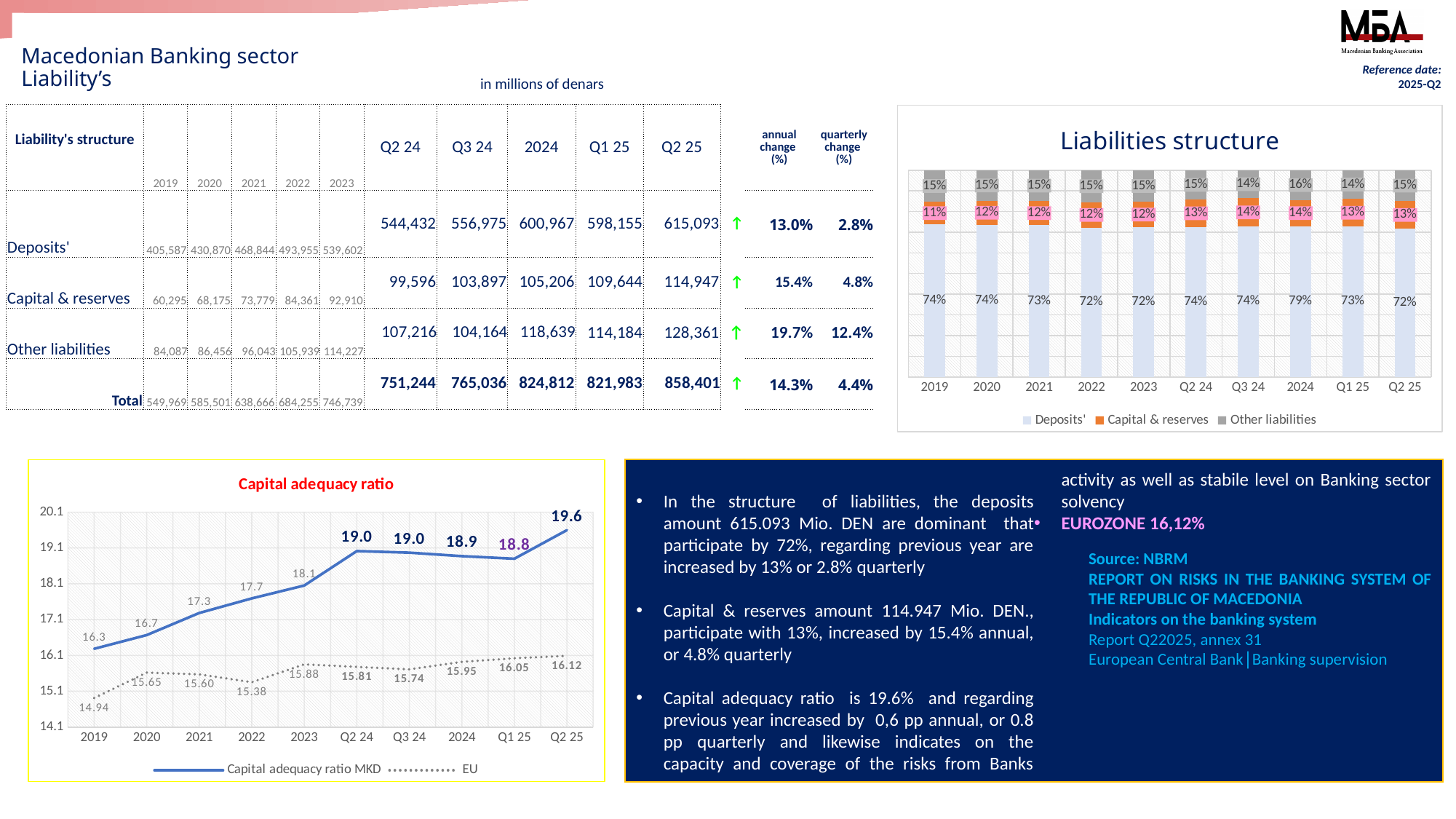
In the Capital adequacy ratio chart, which series has the higher value in 2024, Capital adequacy ratio MKD or EU? Capital adequacy ratio MKD In the Capital adequacy ratio chart, what is the EU value for 2019? 14.94 In the Liabilities structure chart, which period has the highest Deposits' share? 2024 How many periods are shown on the x axis of the Liabilities structure chart? 10 In the Liabilities structure chart, what is the Capital & reserves share in 2019? 11% In the Capital adequacy ratio chart, in which period is the EU value lowest? 2019 In the Capital adequacy ratio chart, by how much did the Capital adequacy ratio MKD increase from 2019 to Q2 25? 3.3 What kind of chart is the Liabilities structure chart? Stacked bar chart In the Liabilities structure chart, what share do Deposits' have in Q2 25? 72% In the Capital adequacy ratio chart, what is the Capital adequacy ratio MKD value for Q2 25? 19.6 In the Capital adequacy ratio chart, does the Capital adequacy ratio MKD rise or fall from 2019 to 2023? Rise How many series does the legend of the Liabilities structure chart list? 3